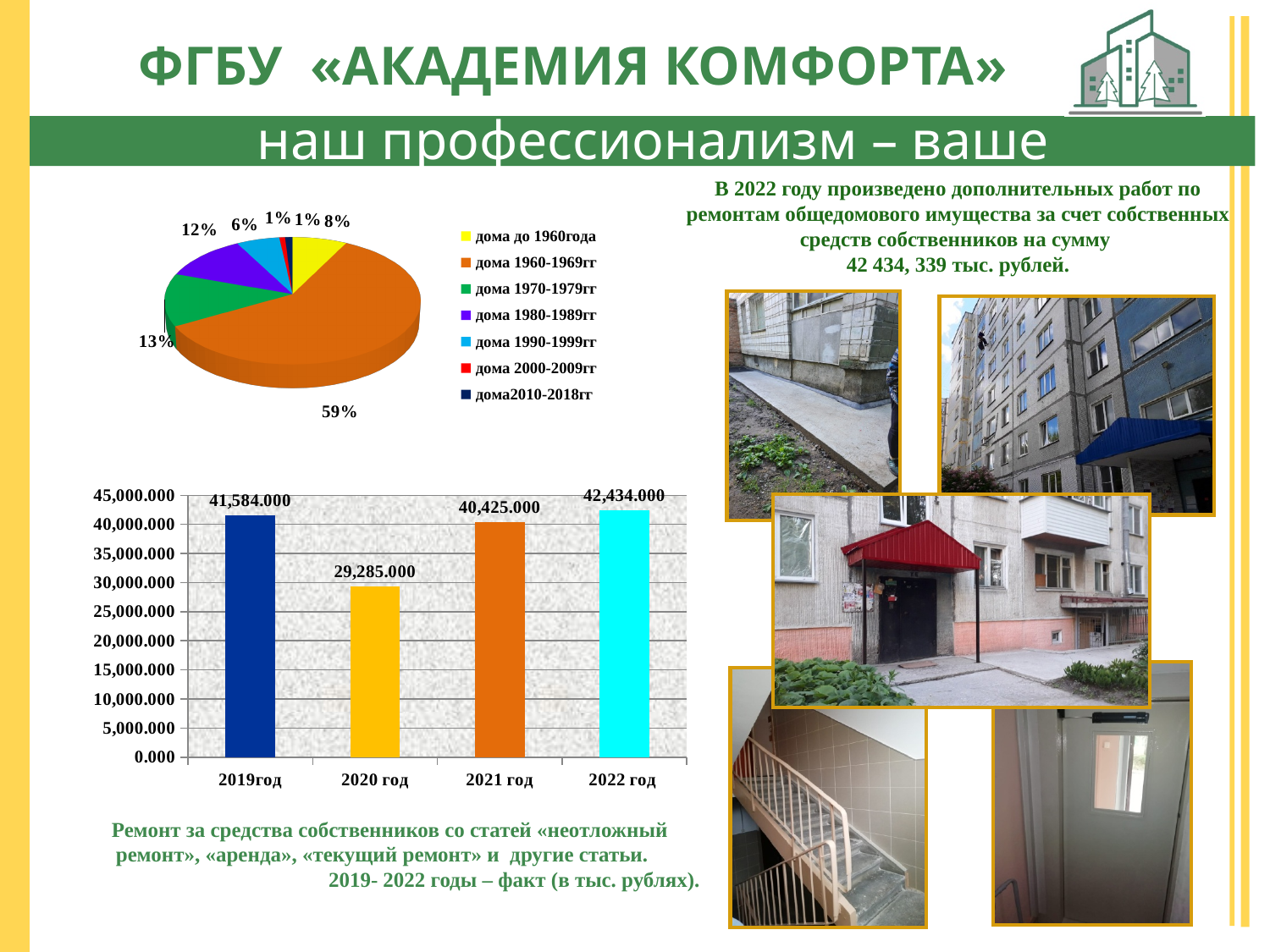
How many categories does the legend of the pie chart at the top left list? 7 In the bar chart at the bottom left, which is larger: the value for 2019год or the value for 2021 год? 2019год In the bar chart at the bottom left, which year has the highest value? 2022 год In the pie chart at the top left, what share does the slice for дома 1960-1969гг have? 59% In the bar chart at the bottom left, what is the value for 2020 год? 29,285.000 In the bar chart at the bottom left, what is the value for 2022 год? 42,434.000 In the pie chart at the top left, which category has the largest slice? дома 1960-1969гг In the bar chart at the bottom left, which year has the lowest value? 2020 год In the bar chart at the bottom left, what is the difference between the values for 2019год and 2020 год? 12,299.000 In the bar chart at the bottom left, do the values rise or fall from 2020 год to 2022 год? rise In the bar chart at the bottom left, is the value for 2020 год greater or less than 30,000.000? less What kind of chart is shown at the bottom left of the slide? bar chart